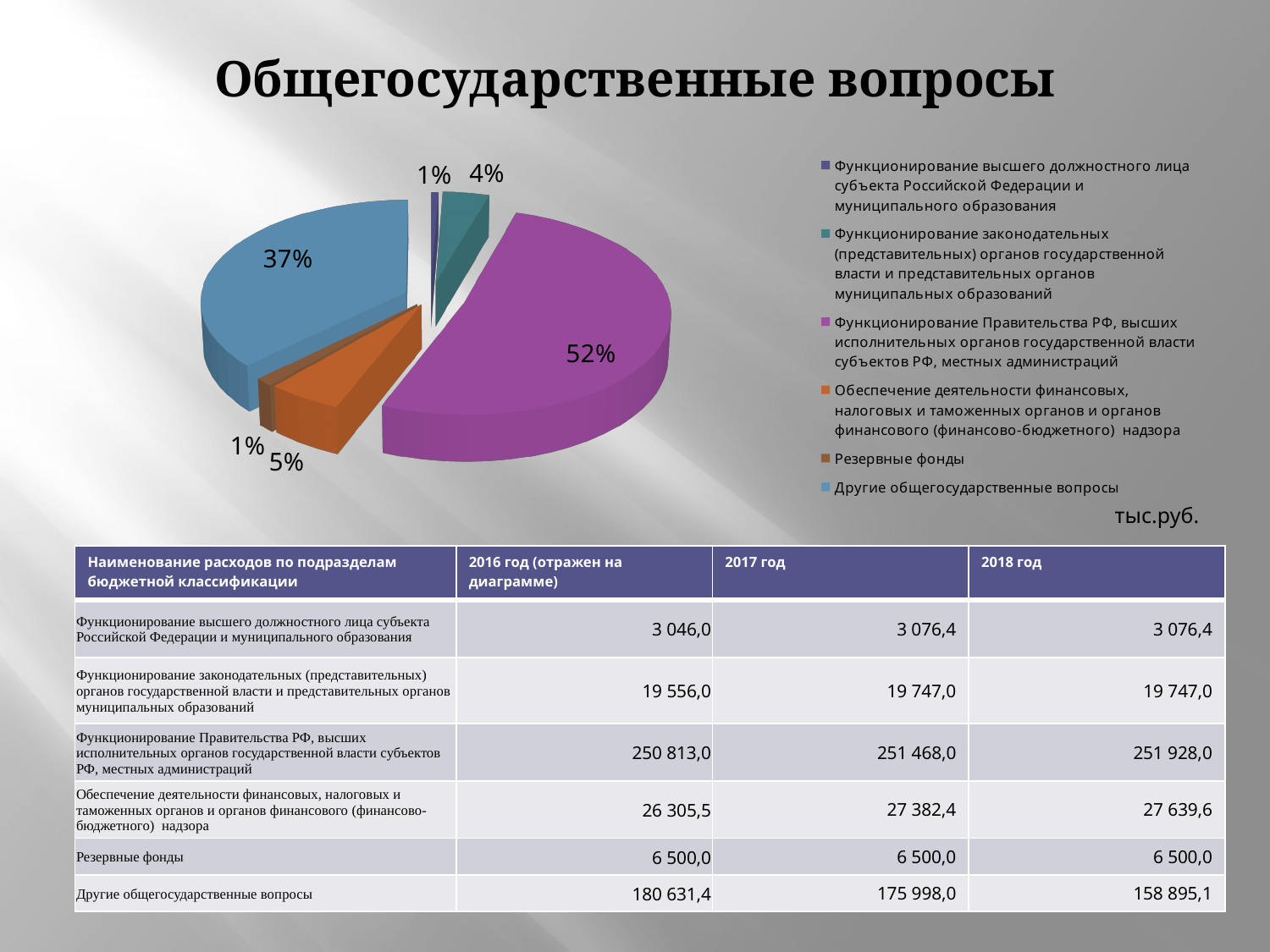
What is the title of the slide containing the pie chart? Общегосударственные вопросы What is the difference in percentage points between the 52% slice and the 37% slice? 15 What colour is the slice representing "Другие общегосударственные вопросы"? Light blue What percentage is shown for "Функционирование законодательных (представительных) органов государственной власти и представительных органов муниципальных образований"? 4% What share of the pie does "Другие общегосударственные вопросы" have? 37% What kind of chart is shown on the slide? Pie chart What share of the pie does "Функционирование Правительства РФ, высших исполнительных органов государственной власти субъектов РФ, местных администраций" have? 52% Which category has the largest slice of the pie? Функционирование Правительства РФ, высших исполнительных органов государственной власти субъектов РФ, местных администраций What percentage is shown for "Резервные фонды"? 1% What percentage is shown for "Обеспечение деятельности финансовых, налоговых и таможенных органов и органов финансового (финансово-бюджетного) надзора"? 5% How many categories does the legend of the pie chart list? 6 Which is larger: the share for "Обеспечение деятельности финансовых, налоговых и таможенных органов..." or the share for "Функционирование законодательных (представительных) органов..."? Обеспечение деятельности финансовых, налоговых и таможенных органов и органов финансового (финансово-бюджетного) надзора